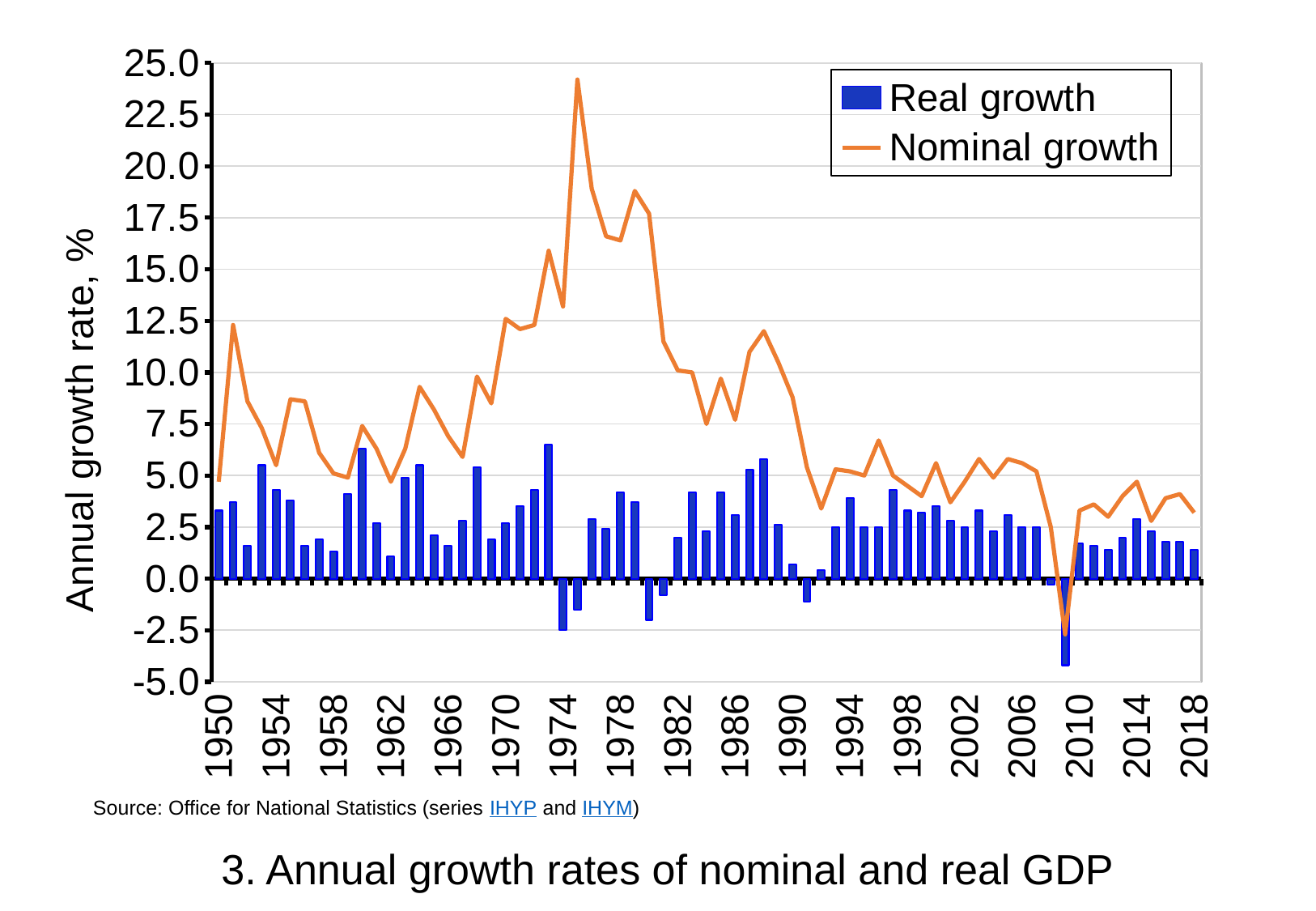
Does the Nominal growth line generally rise or fall between 1975 and 1990? fall What is the title of the chart? 3. Annual growth rates of nominal and real GDP Is the Real growth value in 2009 greater or less than -2.5? less Is the Nominal growth value in 2018 greater or less than 5.0? less Is the Real growth value in 1973 greater or less than 5.0? greater In which year does the Nominal growth line reach its highest value? 1975 Which is larger in 1975, Nominal growth or Real growth? Nominal growth How many series does the legend list? 2 What is the label on the vertical axis? Annual growth rate, % In which year is the Real growth bar at its lowest value? 2009 What kind of chart is this? Combined bar and line chart